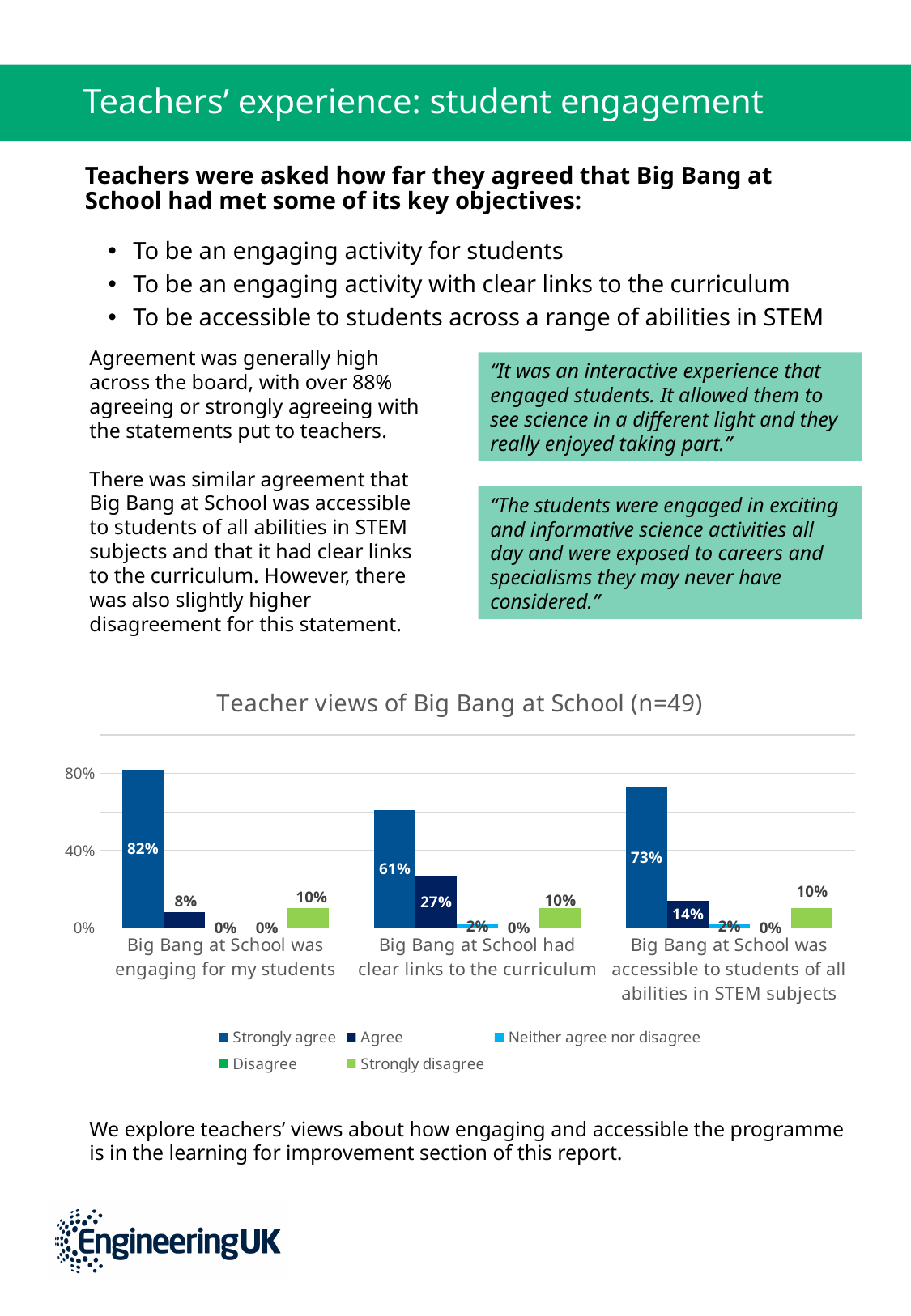
What percentage of teachers neither agreed nor disagreed that Big Bang at School had clear links to the curriculum? 2% How many statement categories are shown on the x axis? 3 What type of chart is shown on the slide? Bar chart What is the chart's title? Teacher views of Big Bang at School (n=49) What percentage of teachers agreed that Big Bang at School had clear links to the curriculum? 27% Which statement has the lowest Strongly agree percentage? Big Bang at School had clear links to the curriculum Which is larger: the Agree percentage for 'clear links to the curriculum' or the Agree percentage for 'accessible to students of all abilities in STEM subjects'? Clear links to the curriculum What is the difference between the Strongly agree percentages for 'engaging for my students' and 'clear links to the curriculum'? 21% What percentage of teachers strongly agreed that Big Bang at School was accessible to students of all abilities in STEM subjects? 73% How many series does the legend list? 5 What percentage of teachers strongly agreed that Big Bang at School was engaging for my students? 82% Which statement has the highest Strongly agree percentage? Big Bang at School was engaging for my students